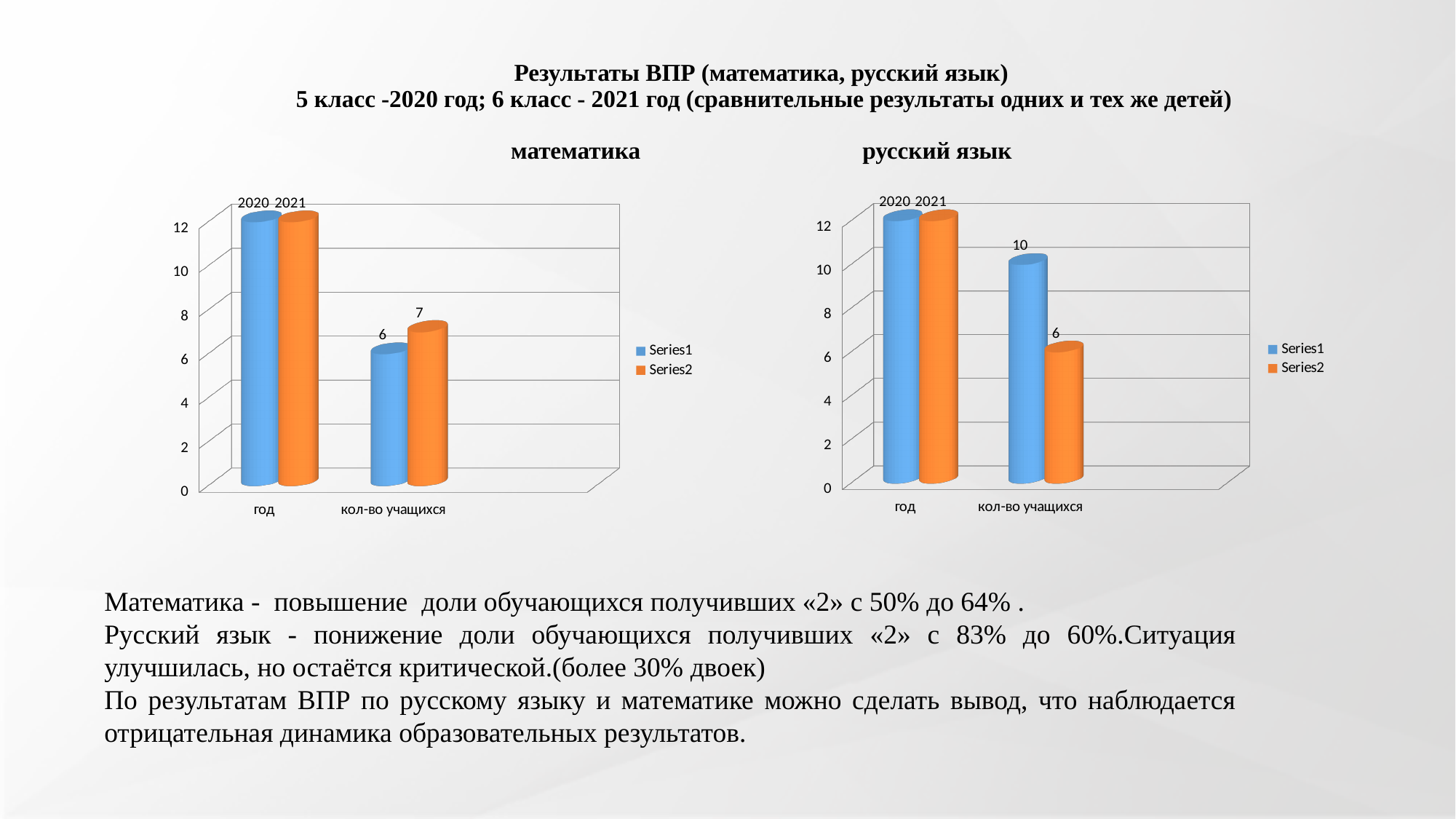
In the математика chart, what is the value of Series1 for кол-во учащихся? 6 What is the title of the chart on the left side of the slide? математика In the русский язык chart, which series has the larger value for кол-во учащихся, Series1 or Series2? Series1 In the русский язык chart, what is the value of Series1 for кол-во учащихся? 10 What kind of chart is the русский язык chart? Bar chart In the математика chart, what is the difference between Series2 and Series1 for кол-во учащихся? 1 How many categories are shown on the x axis of the русский язык chart? 2 In the русский язык chart, what is the value of Series2 for кол-во учащихся? 6 In the математика chart, which series has the larger value for кол-во учащихся, Series1 or Series2? Series2 How many series does the legend of the математика chart list? 2 In the математика chart, what is the value of Series2 for кол-во учащихся? 7 In the русский язык chart, what is the difference between Series1 and Series2 for кол-во учащихся? 4